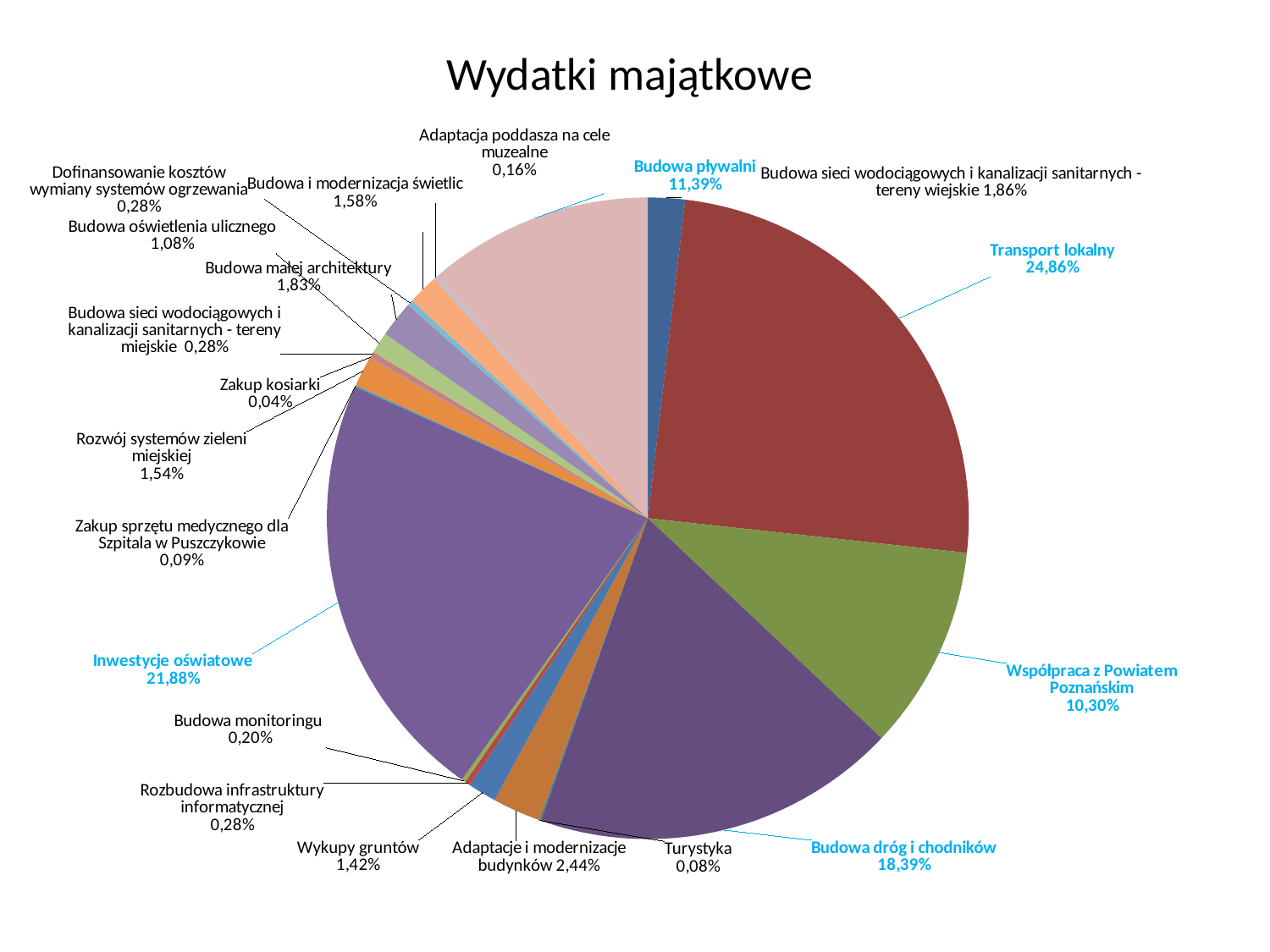
Which is larger: Budowa pływalni or Współpraca z Powiatem Poznańskim? Budowa pływalni What type of chart is shown on the slide? pie chart What is the value shown for Inwestycje oświatowe? 21,88% Which category has the largest share of the pie? Transport lokalny What percentage is shown for Budowa dróg i chodników? 18,39% What is the value for Adaptacje i modernizacje budynków? 2,44% Which category has the smallest share of the pie? Zakup kosiarki What is the difference in percentage points between Transport lokalny and Inwestycje oświatowe? 2,98 How many categories (slices) are shown in the pie chart? 20 What is the difference in percentage points between Budowa dróg i chodników and Budowa pływalni? 7,00 What share of the pie does Transport lokalny represent? 24,86% What is the title of the chart? Wydatki majątkowe